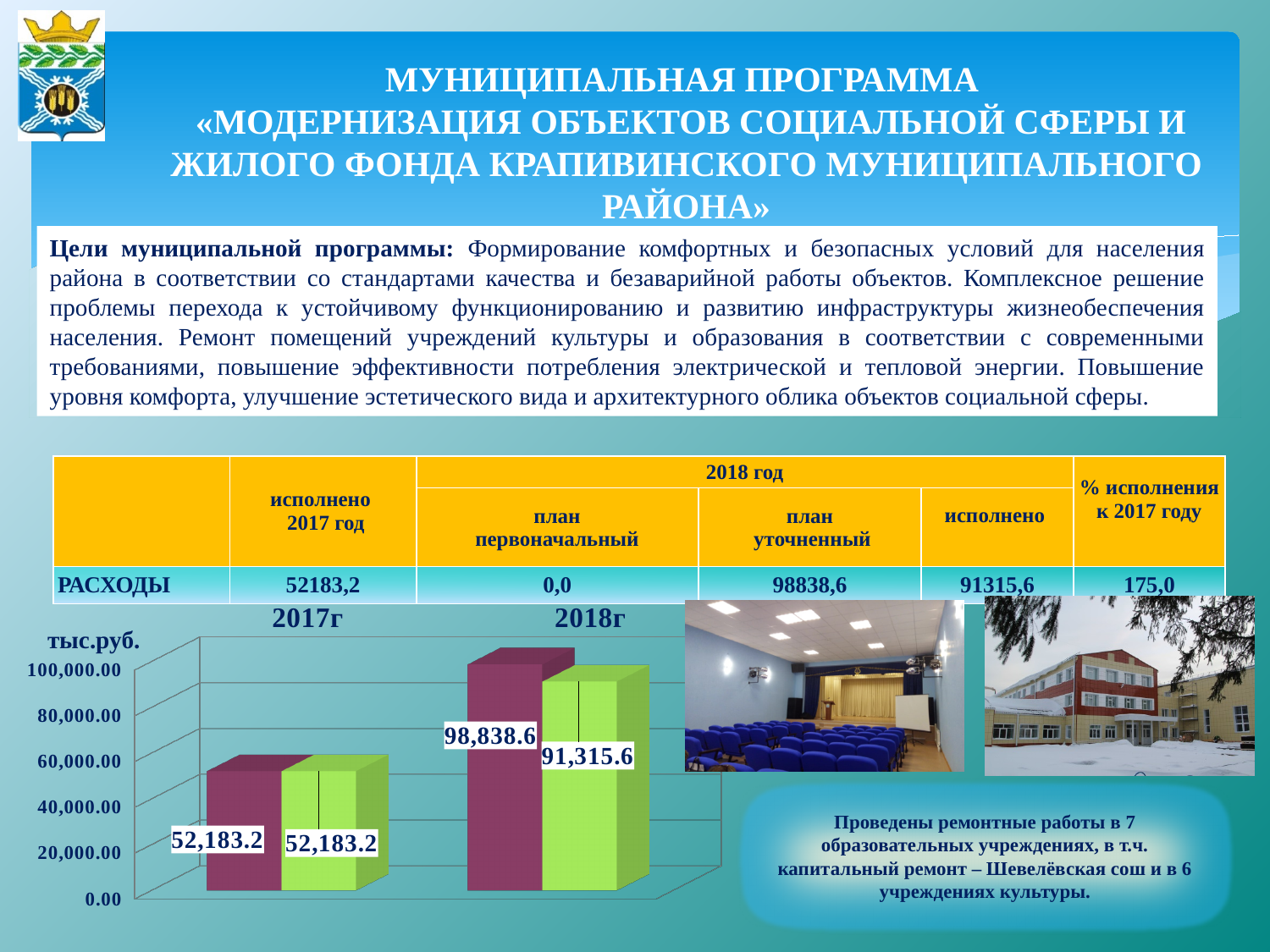
What is the value of the purple bar for 2018г in the chart? 98,838.6 Which category has the highest bar in the chart? 2018г Is the green bar for 2018г greater or less than 80,000.00? greater What is the value of the green bar for 2018г in the chart? 91,315.6 What is the value of the green bar for 2017г in the chart? 52,183.2 What is the difference between the purple bars for 2018г and 2017г? 46,655.4 Which is larger for 2018г, the purple bar or the green bar? the purple bar What is the difference between the purple and green bars for 2018г? 7,523.0 What unit is shown on the vertical axis of the chart? тыс.руб. What type of chart is shown on the slide? bar chart What is the value of the purple bar for 2017г in the chart? 52,183.2 How many categories are shown on the x axis of the chart? 2